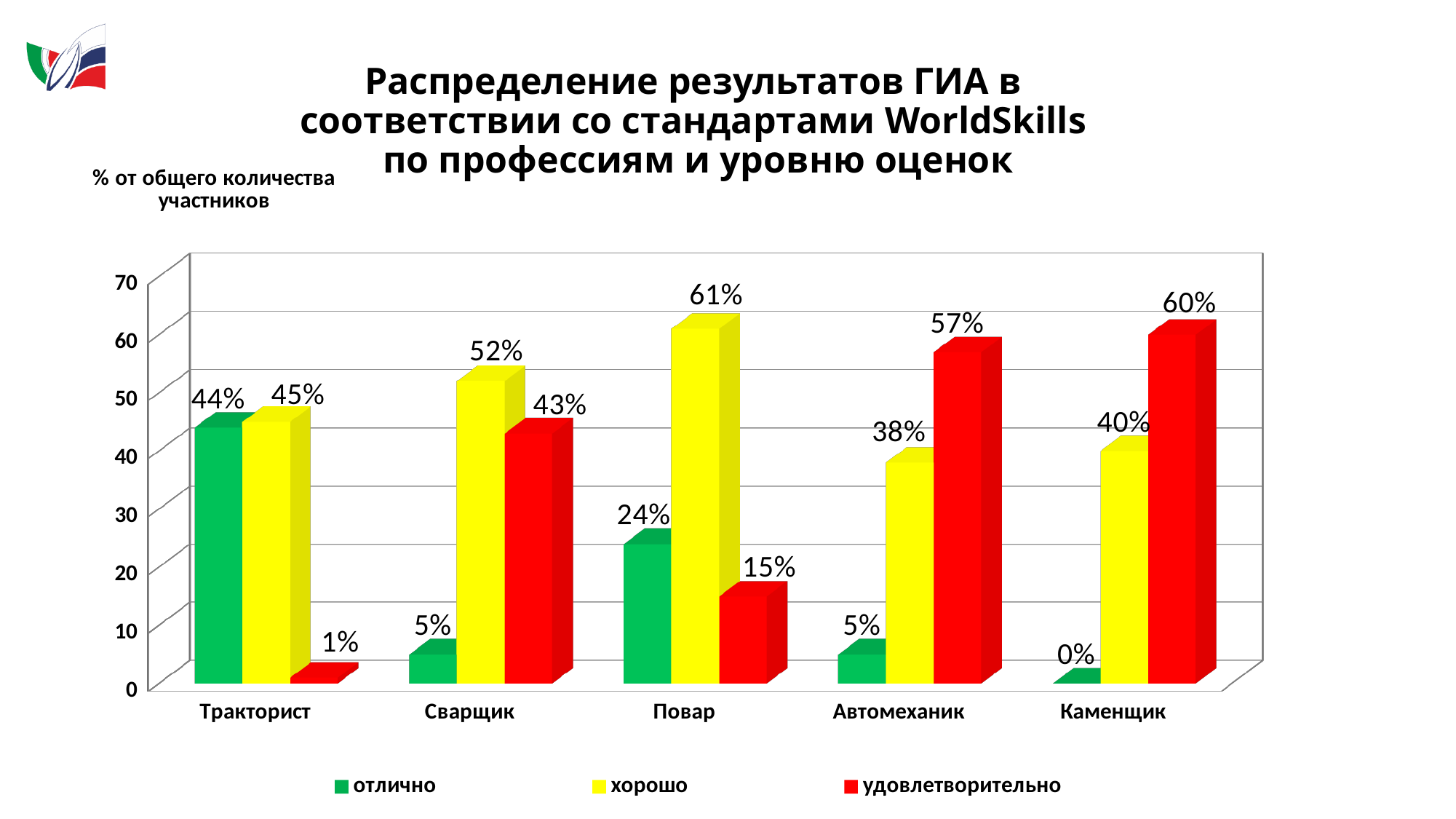
Which colour represents the "удовлетворительно" series? Red What is the difference between the "удовлетворительно" values for Автомеханик and Повар? 42% Which profession has the highest value for "хорошо"? Повар What is the value for "хорошо" for Повар? 61% What is the value for "удовлетворительно" for Каменщик? 60% What is the value for "отлично" for Автомеханик? 5% What is the value for "отлично" for Тракторист? 44% How many series does the legend list? 3 How many professions are shown on the x axis? 5 Which profession has the lowest value for "отлично"? Каменщик What kind of chart is shown on the slide? Bar chart Which is larger for Сварщик: "хорошо" or "удовлетворительно"? хорошо